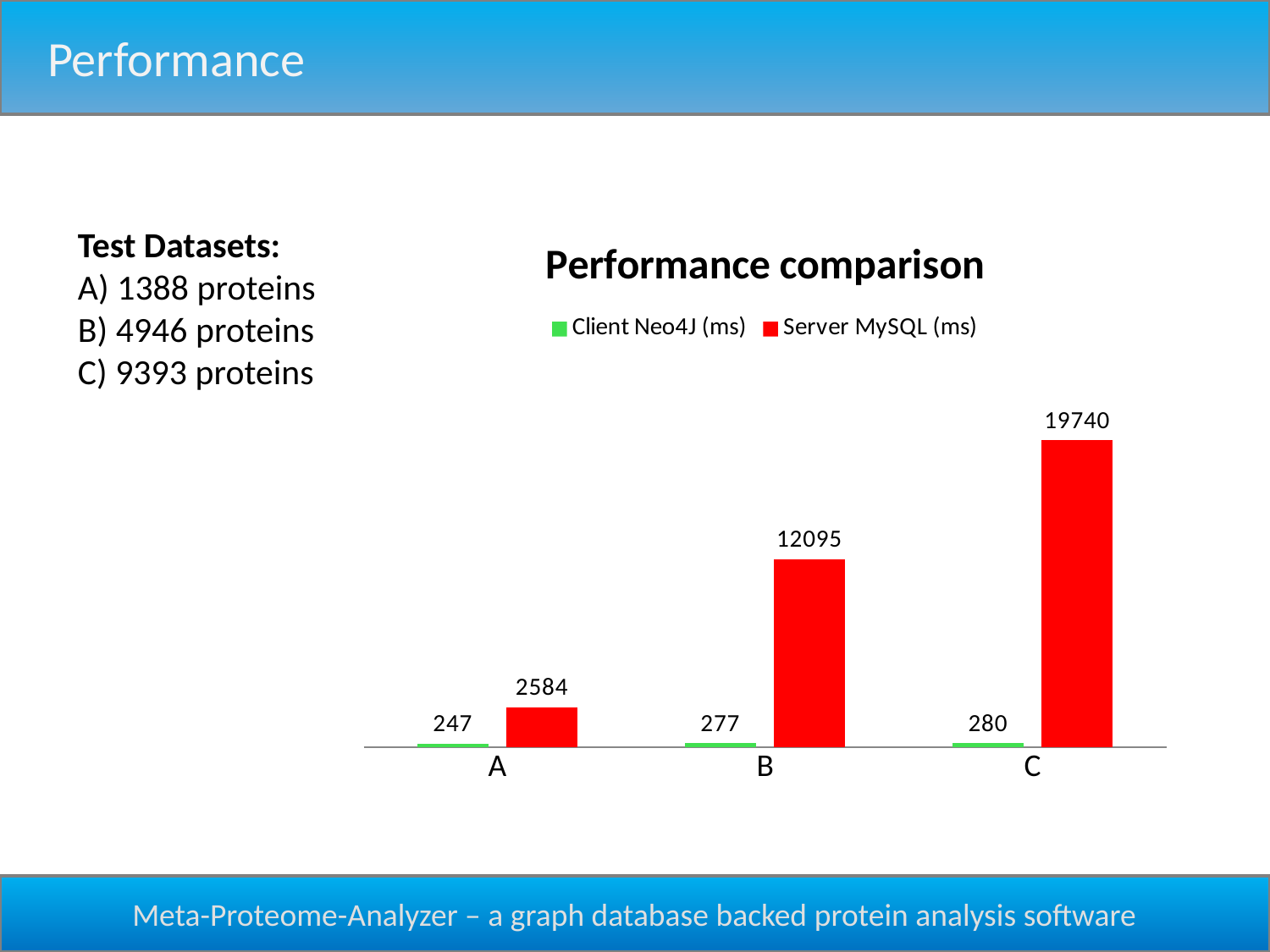
How many datasets are shown on the x axis of the chart? 3 What kind of chart is shown on the slide? Bar chart What is the Client Neo4J (ms) value for dataset A? 247 Which dataset has the highest Server MySQL (ms) value? C How many series does the chart legend list? 2 Do the Server MySQL (ms) values rise or fall from dataset A to dataset C? Rise Which dataset has the lowest Client Neo4J (ms) value? A What is the Client Neo4J (ms) value for dataset C? 280 What is the Server MySQL (ms) value for dataset C? 19740 What is the Server MySQL (ms) value for dataset B? 12095 Which is larger for dataset B: the Client Neo4J (ms) value or the Server MySQL (ms) value? Server MySQL (ms) What is the difference between the Server MySQL (ms) and Client Neo4J (ms) values for dataset A? 2337